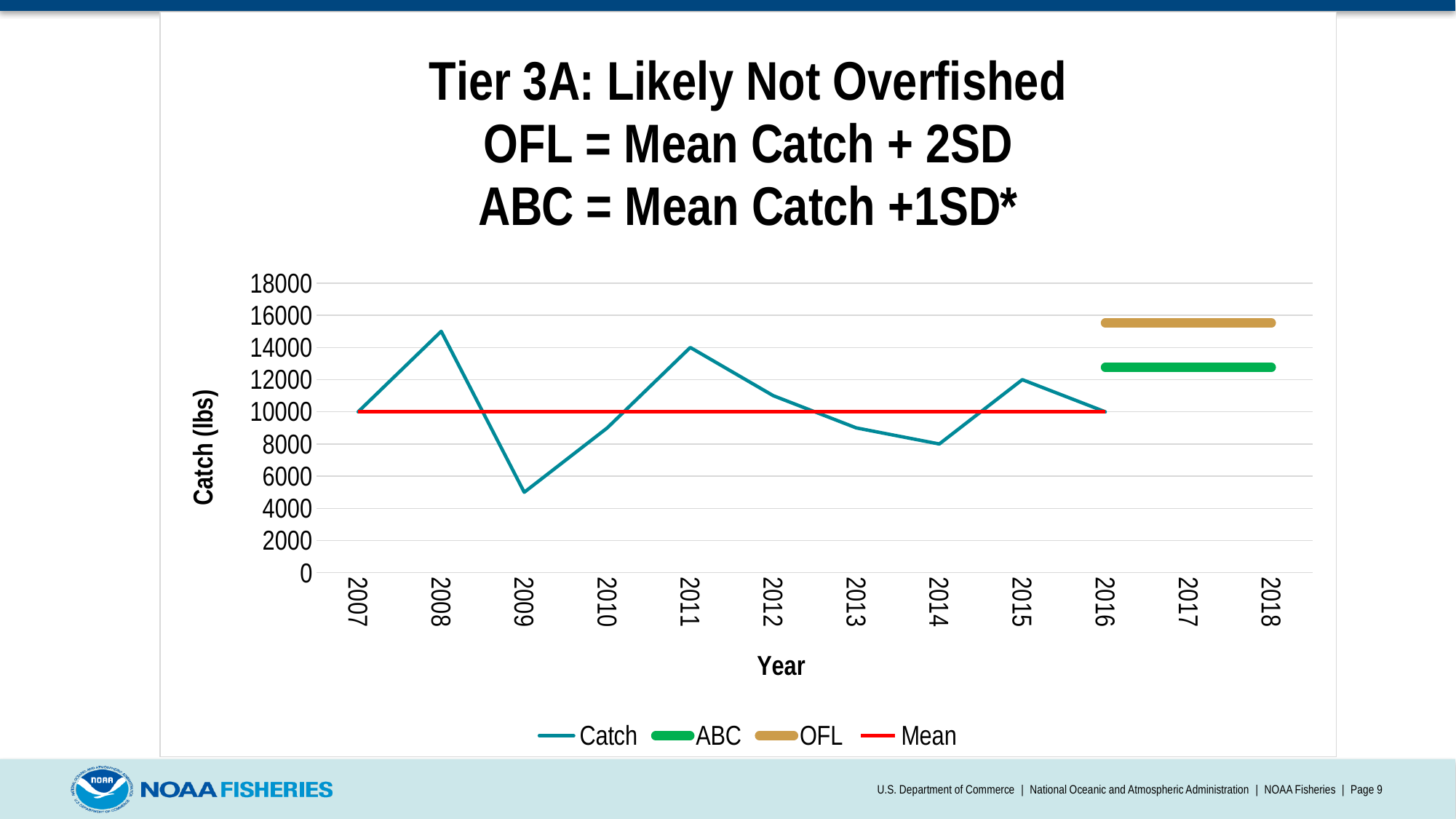
Is the OFL line greater or less than 14000? greater What value does the Mean line sit at? 10000 Does the Catch rise or fall from 2011 to 2014? fall How many years are shown on the x axis? 12 In which year is the Catch highest? 2008 What is the Catch value for 2011? 14000 Is the Catch value for 2008 greater or less than 14000? greater In which year is the Catch lowest? 2009 What kind of chart is shown on the slide? line chart Is the Catch value for 2009 greater or less than 6000? less Which year has the larger Catch, 2011 or 2013? 2011 How many series does the legend list? 4